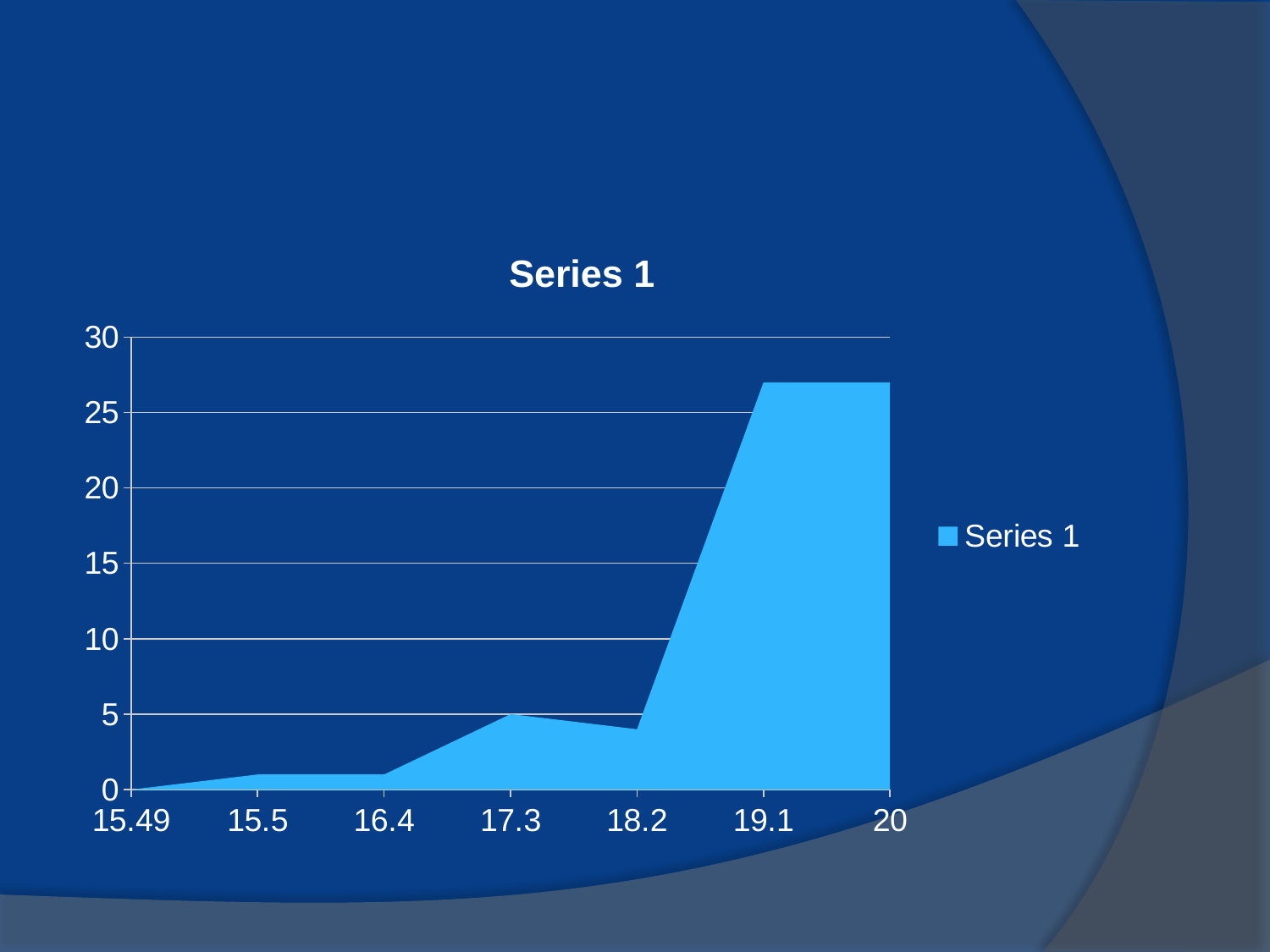
How many categories are shown on the x axis? 7 Which is larger, the value at 19.1 or the value at 17.3? 19.1 How many series does the legend list? 1 Is the value at 15.5 greater or less than 5? less Is the value at 18.2 greater or less than 5? less What is the value at 15.49? 0 Do the values generally rise or fall from 15.49 to 20 along the x axis? Rise Which category has the lowest value? 15.49 What is the title of the chart? Series 1 Is the value at 19.1 greater or less than 25? greater What kind of chart is shown on the slide? Area chart What is the value at 17.3? 5